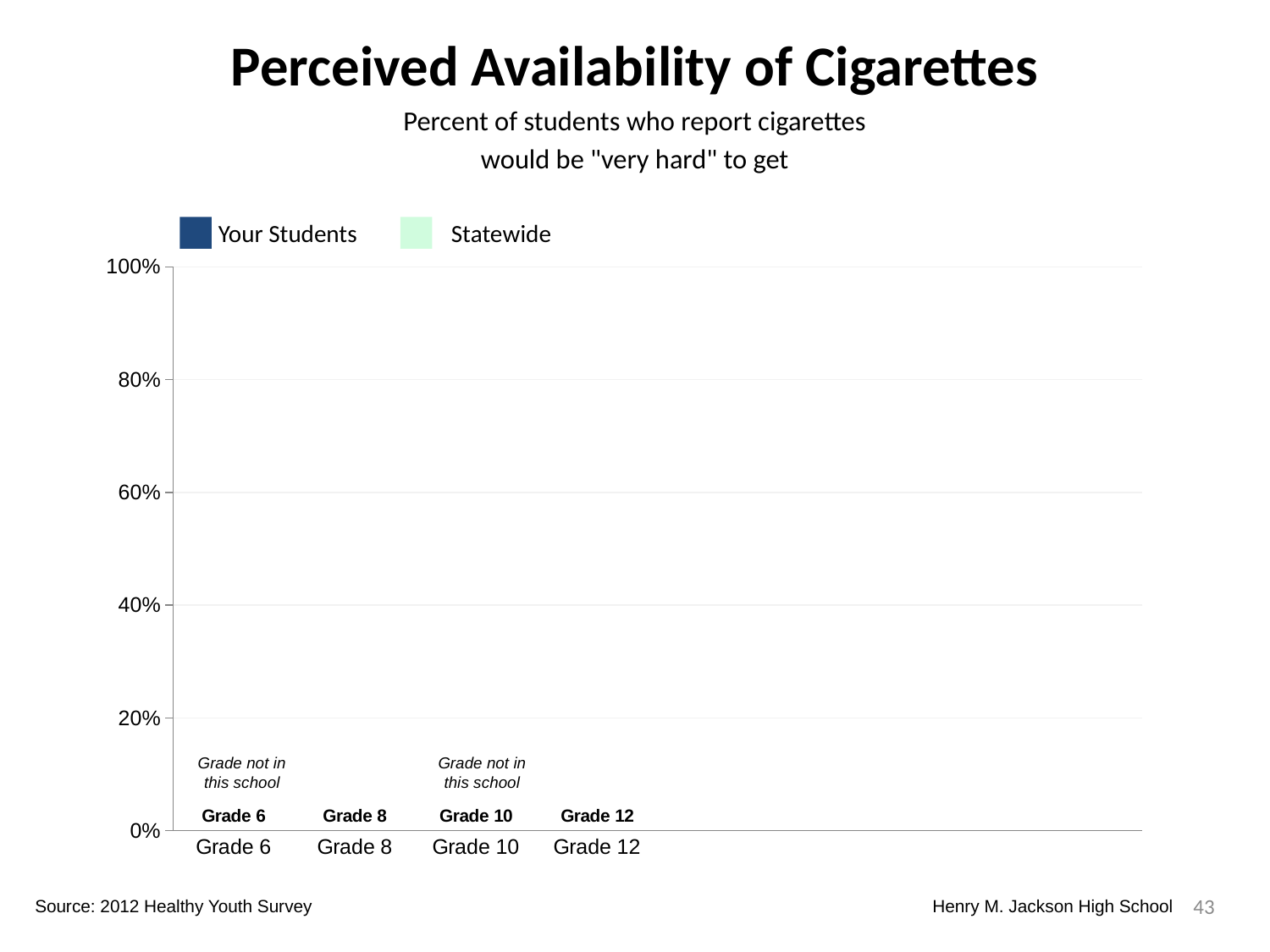
Which grades are marked as "Grade not in this school"? Grade 6 and Grade 10 What is the highest value shown on the y axis? 100% How many grade categories are shown on the x axis? 4 What is the title of the chart? Perceived Availability of Cigarettes How many series does the legend list? 2 What are the two series named in the legend? Your Students and Statewide